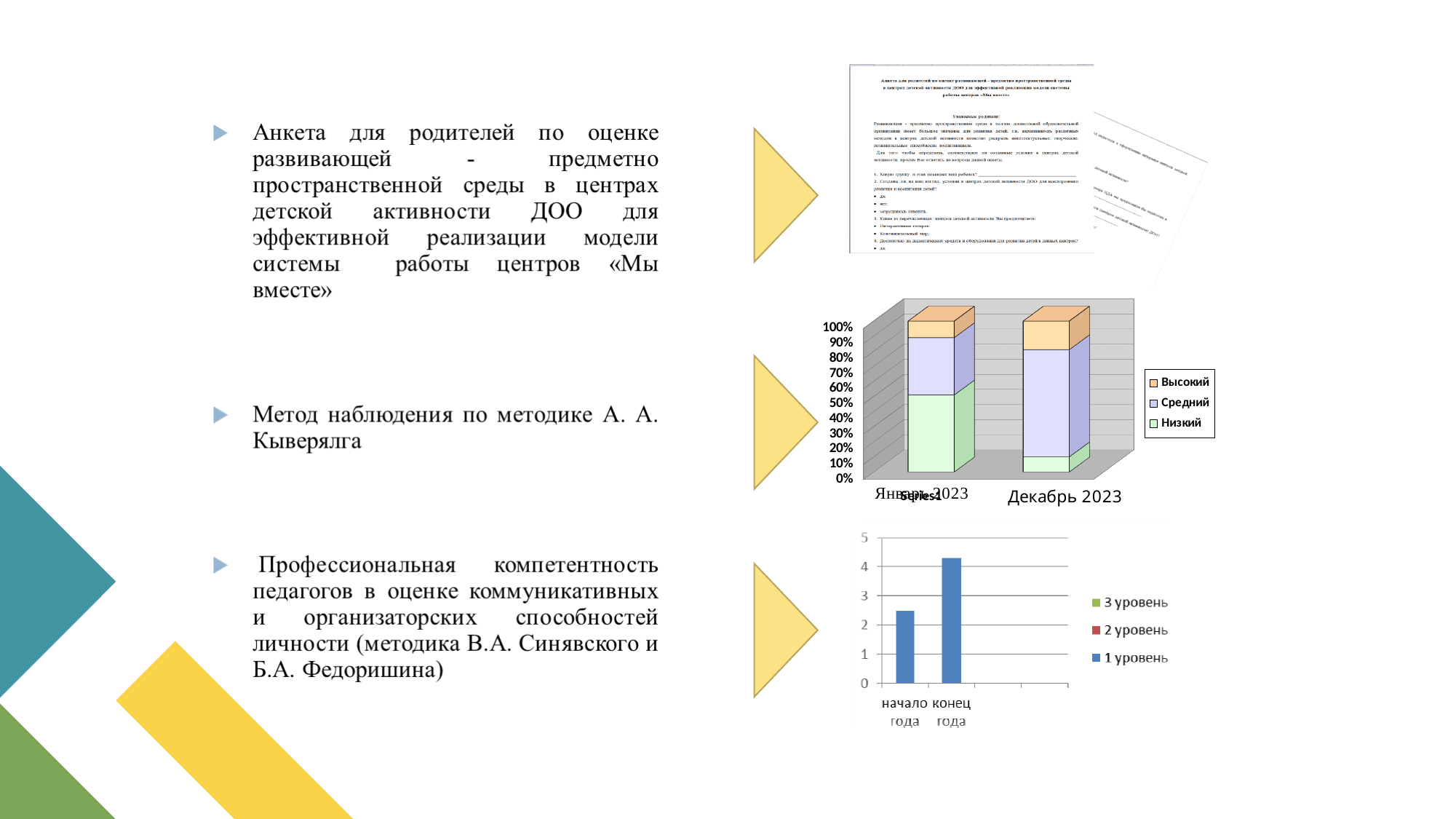
In the upper stacked chart, which series is shown in green in the legend? Низкий In the upper stacked chart, how many categories are shown on the x axis? 2 What kind of chart is the lower chart with the начало года and конец года categories? bar chart In the upper stacked chart, is the Средний share larger for Январь 2023 or for Декабрь 2023? Декабрь 2023 In the upper stacked chart, how many series does the legend list? 3 In the upper stacked chart, is the Низкий share larger for Январь 2023 or for Декабрь 2023? Январь 2023 In the upper stacked chart, is the Низкий share for Январь 2023 greater or less than 40%? greater In the lower chart, is the value for начало года greater or less than 3? less In the upper stacked chart, is the Низкий share for Декабрь 2023 greater or less than 20%? less What kind of chart is the upper chart with the Январь 2023 and Декабрь 2023 categories? bar chart In the lower chart, how many series does the legend list? 3